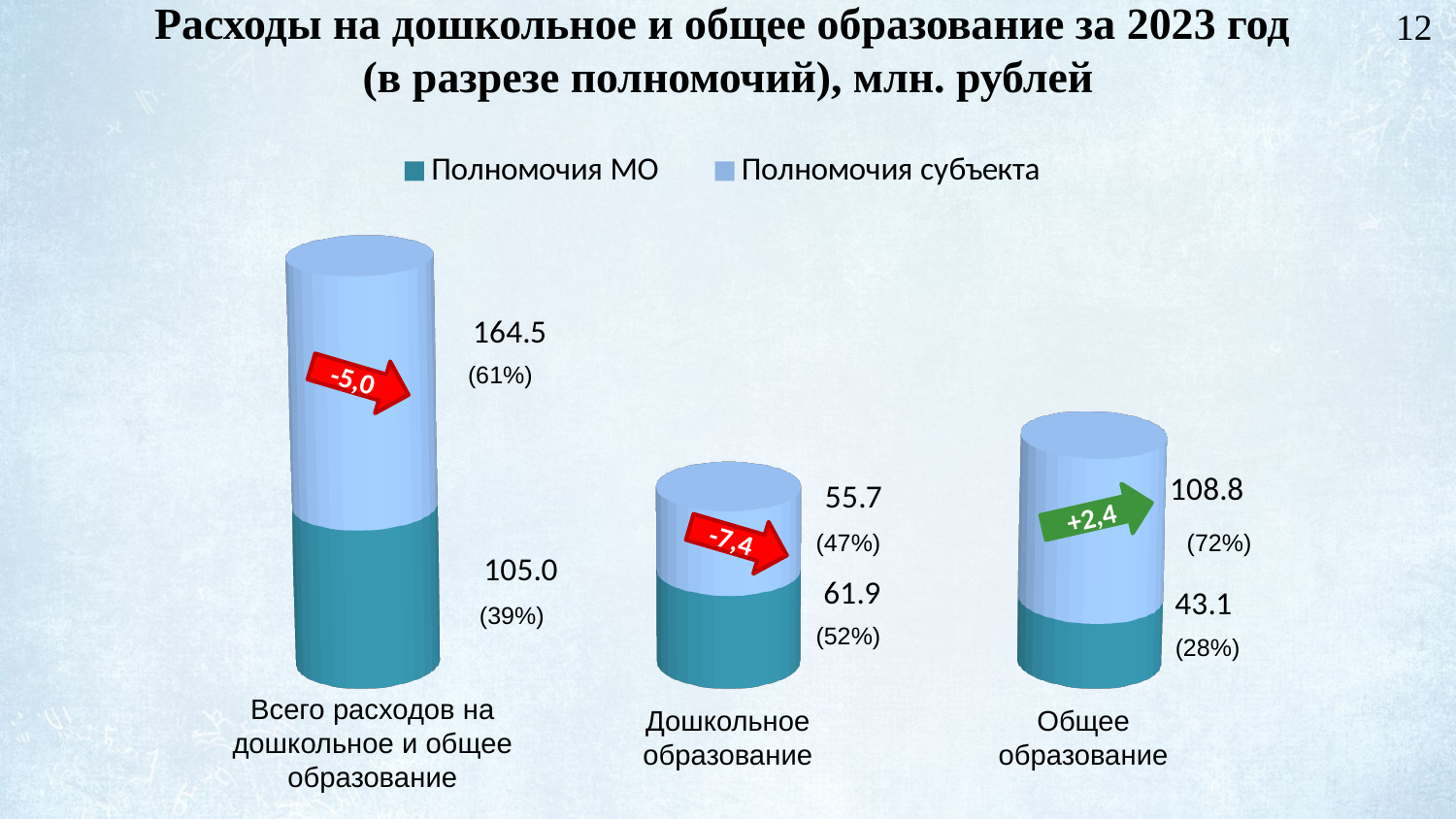
Which category has the highest value for Полномочия МО? Всего расходов на дошкольное и общее образование What is the value for Полномочия субъекта in the category Общее образование? 108.8 What is the total of the stacked bar for Дошкольное образование? 117.6 What is the value for Полномочия субъекта in the category Всего расходов на дошкольное и общее образование? 164.5 What is the value for Полномочия МО in the category Дошкольное образование? 61.9 Which category has the lowest value for Полномочия субъекта? Дошкольное образование Which is larger in the category Дошкольное образование: Полномочия МО or Полномочия субъекта? Полномочия МО How many categories are shown on the chart? 3 What kind of chart is shown on the slide? Stacked bar chart What is the difference between Полномочия субъекта and Полномочия МО in the category Общее образование? 65.7 What is the value for Полномочия МО in the category Общее образование? 43.1 How many series does the legend list? 2